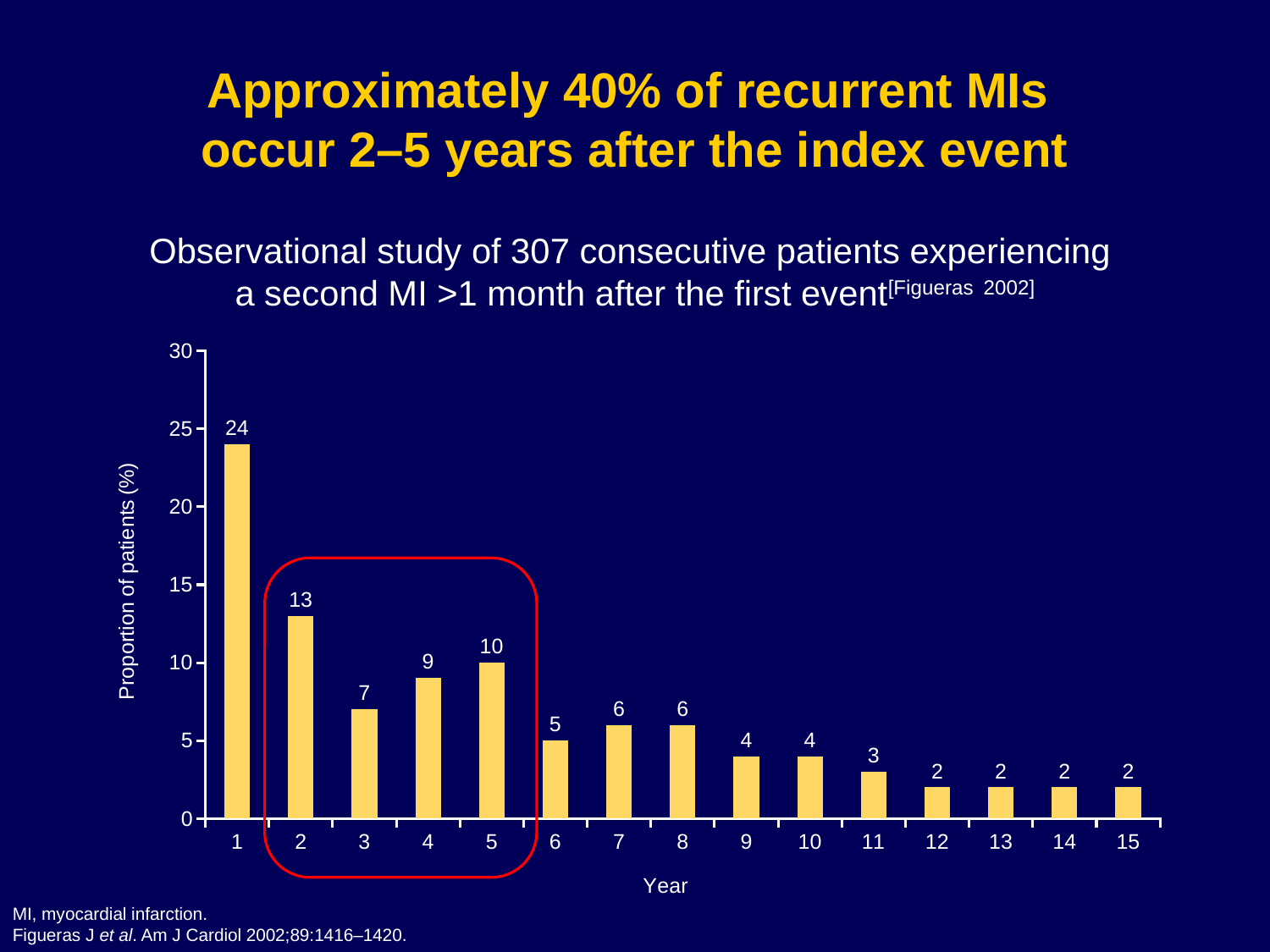
Which year has the highest proportion of patients? 1 What is the proportion of patients (%) for year 1? 24 What is the proportion of patients (%) for year 5? 10 Is the value for year 1 greater or less than 20? greater What kind of chart is shown on the slide? Bar chart What is the difference in proportion of patients between year 4 and year 3? 2 What is the label of the y axis? Proportion of patients (%) What is the difference in proportion of patients between year 1 and year 2? 11 Which has a larger proportion of patients, year 2 or year 6? Year 2 How many years are shown on the x axis? 15 What is the proportion of patients (%) for year 11? 3 Do the values generally rise or fall from year 5 to year 15? Fall